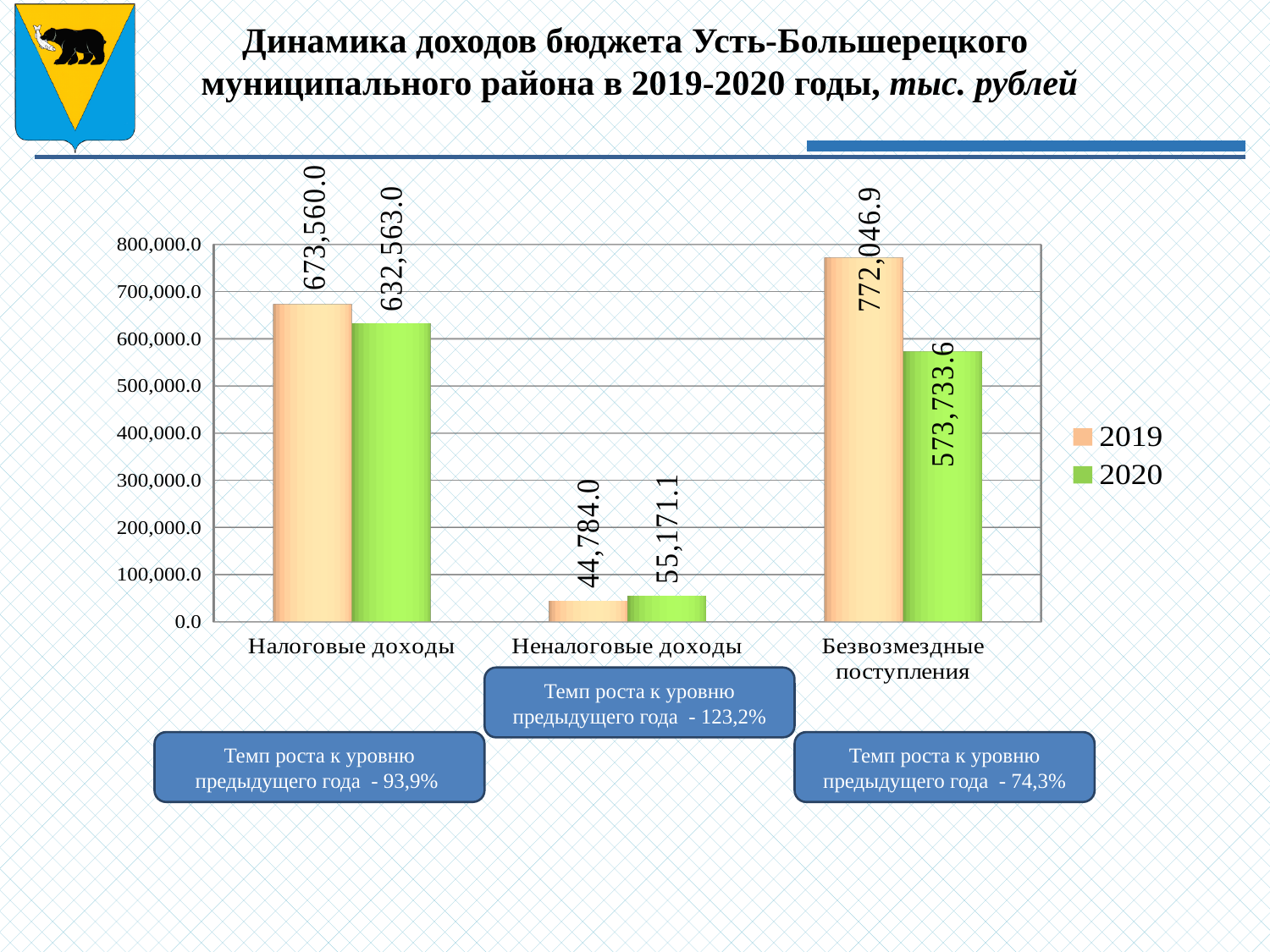
What is the value for Неналоговые доходы in 2020? 55,171.1 Which category has the lowest value in 2020? Неналоговые доходы What is the value for Налоговые доходы in 2019? 673,560.0 Which is larger for Неналоговые доходы: the 2019 value or the 2020 value? 2020 What is the difference between the 2019 and 2020 values for Налоговые доходы? 40,997.0 Which category has the highest value in 2019? Безвозмездные поступления What kind of chart is shown on the slide? bar chart What is the value for Безвозмездные поступления in 2019? 772,046.9 What is the value for Безвозмездные поступления in 2020? 573,733.6 How many categories are shown on the x axis? 3 How many series does the legend list? 2 Is the 2020 value for Безвозмездные поступления greater or less than 600,000.0? less